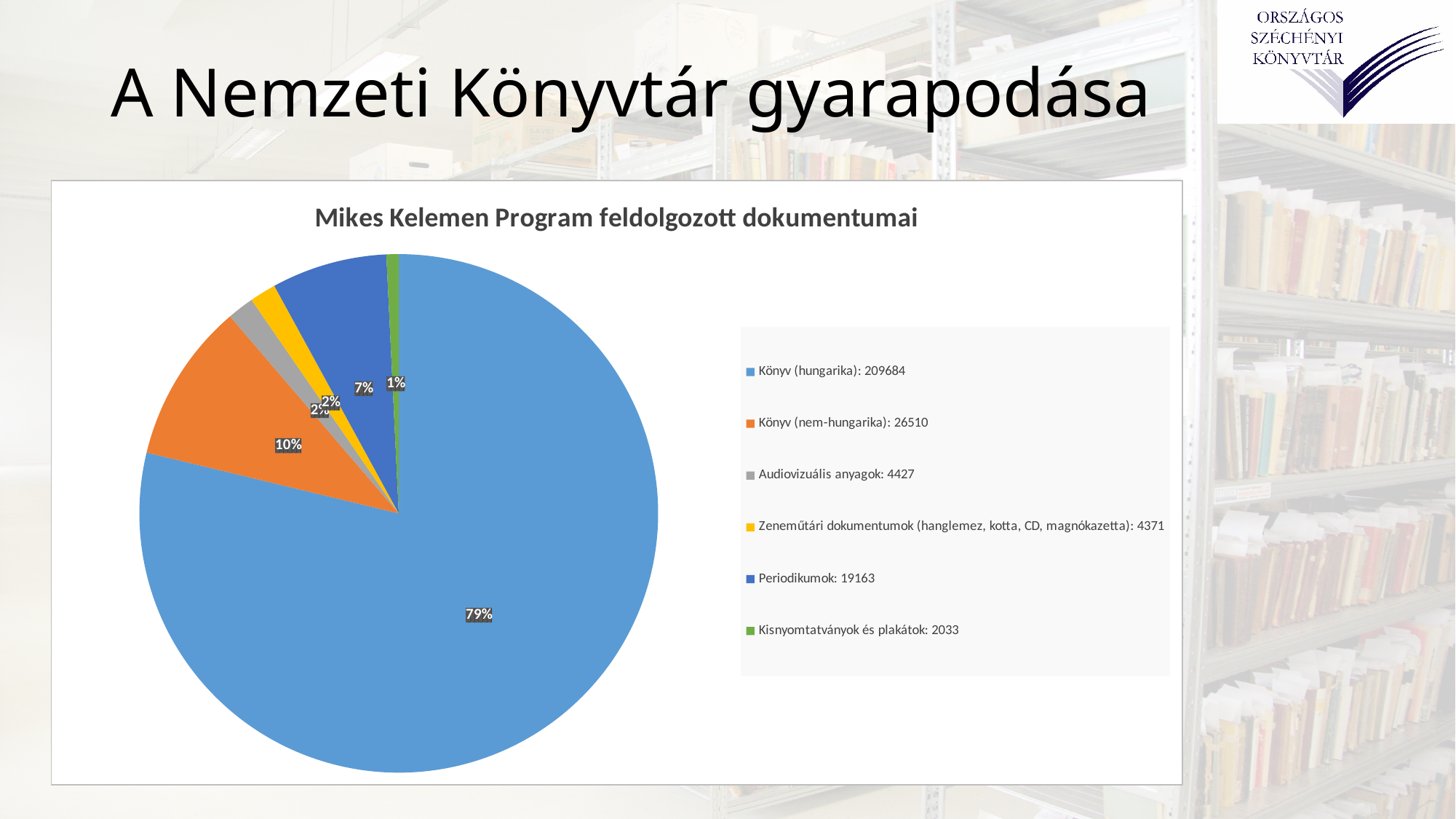
What is the value for Periodikumok? 19163 What share of the pie does Periodikumok represent? 7% Which category has the smallest share of the pie? Kisnyomtatványok és plakátok What is the difference between the values for Könyv (nem-hungarika) and Periodikumok? 7347 What kind of chart is shown on the slide? pie chart What is the value for Könyv (hungarika)? 209684 What is the value for Kisnyomtatványok és plakátok? 2033 How many categories does the pie chart have? 6 Which category has the largest share of the pie? Könyv (hungarika) Which is larger, the value for Periodikumok or the value for Audiovizuális anyagok? Periodikumok What share of the pie does Könyv (nem-hungarika) represent? 10% What is the title of the chart? Mikes Kelemen Program feldolgozott dokumentumai